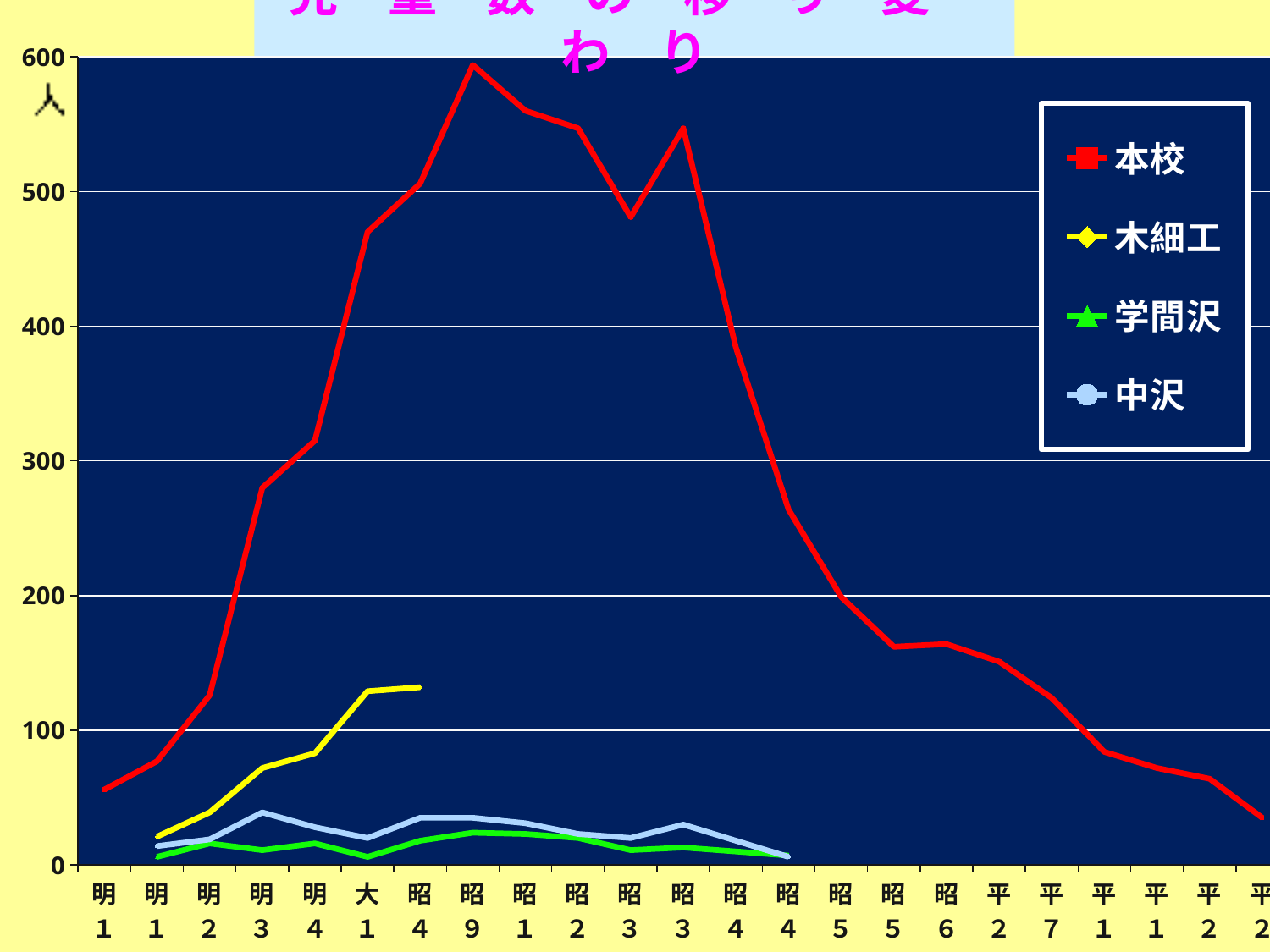
How many series does the legend list? 4 Does the 本校 series rise or fall from its peak at 昭9 to the last category on the x axis? fall Is the value of 本校 at the first category (明1) greater or less than 100? less Which series has the lowest values overall on the chart? 学間沢 Is the peak value of the 本校 series greater or less than 500? greater What kind of chart is shown on the slide? line chart Is the value of 本校 at the last category on the x axis (平2) greater or less than 100? less At the category 昭4 where the 木細工 series ends, which is larger, 木細工 or 中沢? 木細工 Does the 本校 series rise or fall from the first category up to its peak at 昭9? rise What colour is the 本校 series line? red Which series reaches the highest value on the chart? 本校